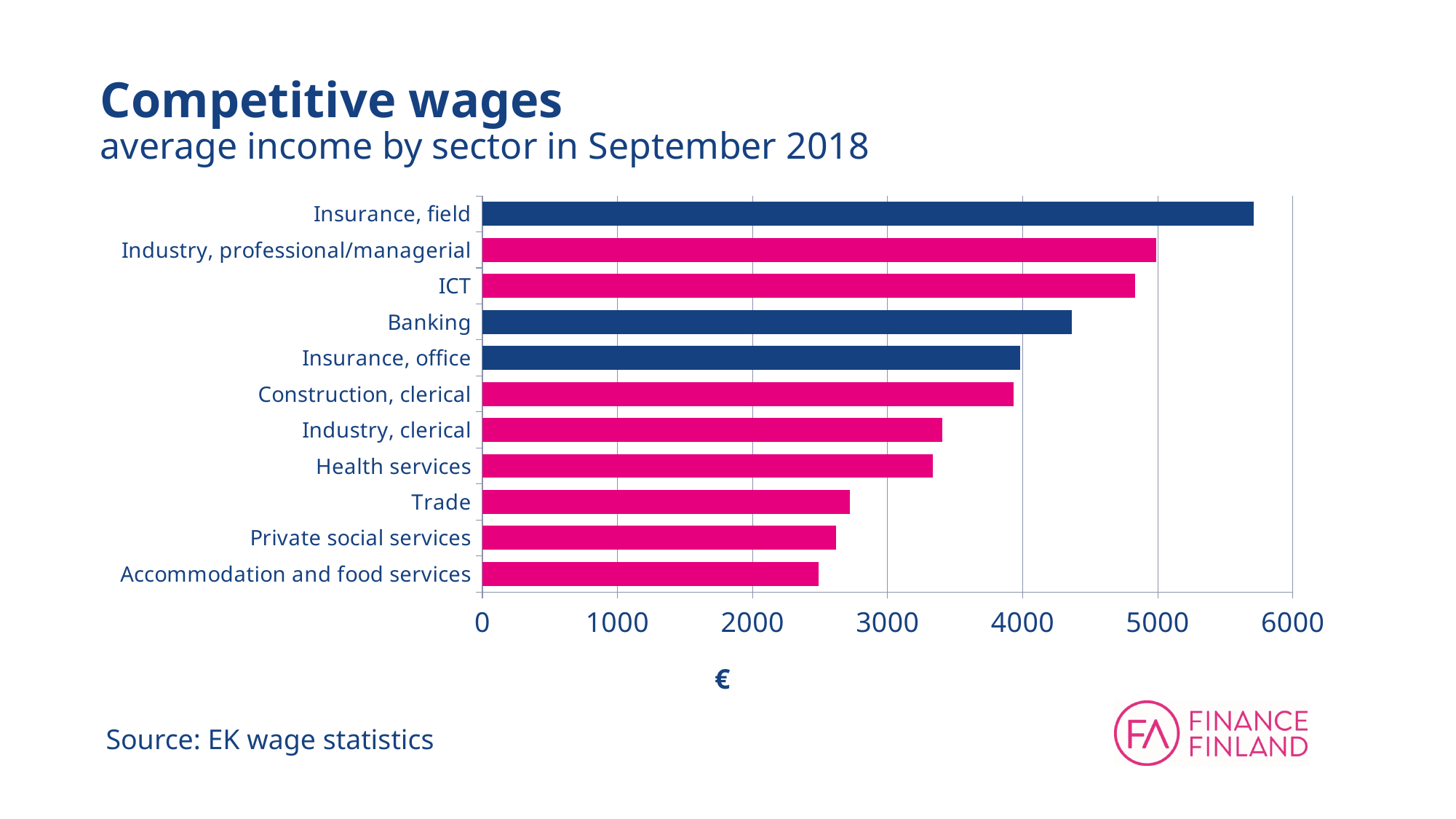
Which has a higher average income, Banking or ICT? ICT Is the value for Trade greater or less than 3000? less What unit is shown on the horizontal axis of the chart? € Which sector has the highest average income? Insurance, field Which sector has the lowest average income? Accommodation and food services Is the value for Insurance, field greater or less than 5000? greater Which has a higher average income, Trade or Health services? Health services Is the value for Banking greater or less than 4000? greater What kind of chart is shown on the slide? bar chart How many sectors are shown in the chart? 11